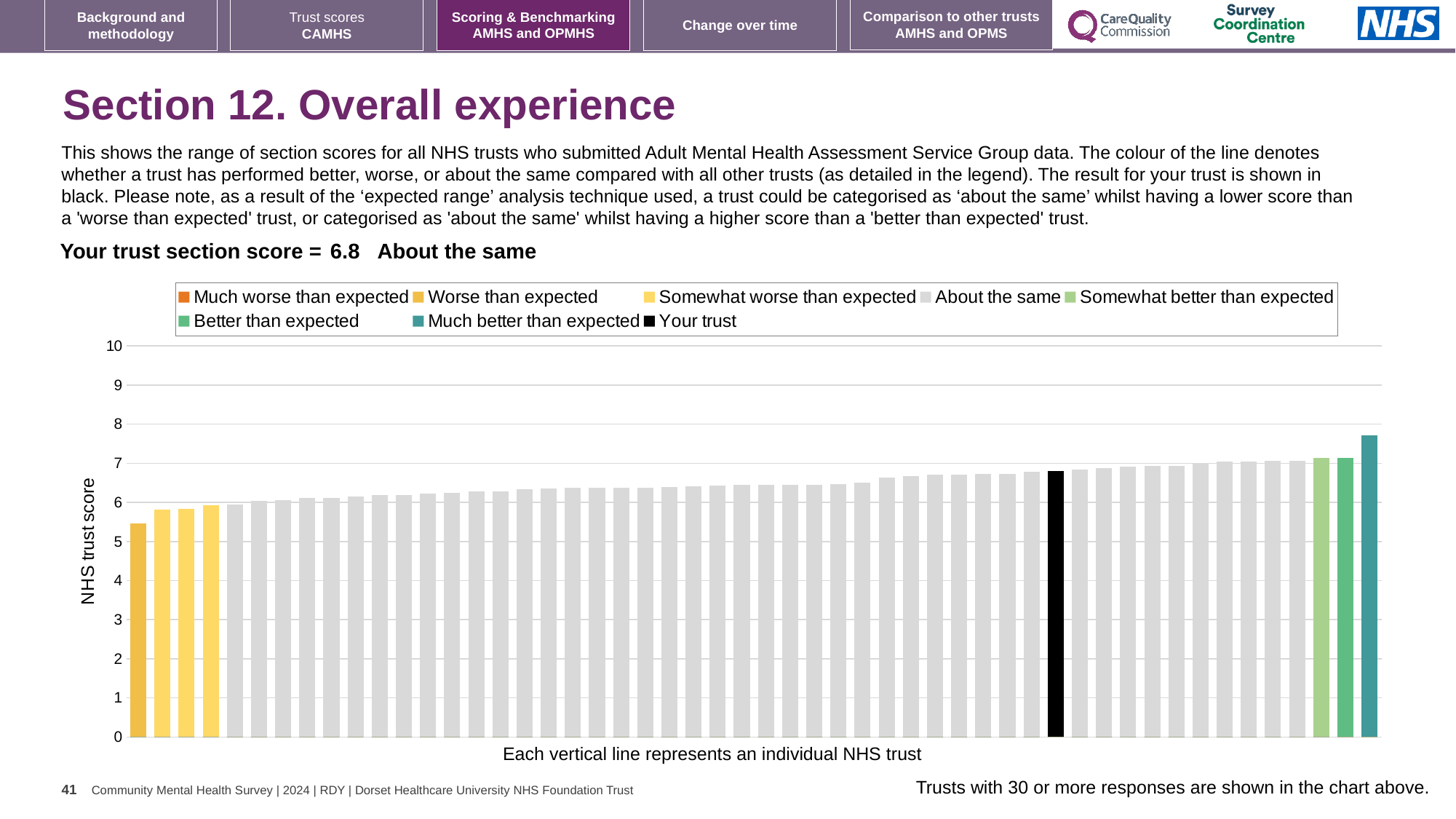
What kind of chart is shown on the slide? bar chart What is the label on the vertical axis of the chart? NHS trust score Is the value of the rightmost teal bar greater or less than 7? greater Is the value of the leftmost (lowest) bar greater or less than 5? greater Do the bar values rise or fall from left to right along the x axis? rise Is the value of the black 'Your trust' bar greater or less than 7? less Which legend category does the tallest bar belong to? Much better than expected How many teal 'Much better than expected' bars are in the chart? 1 Which is larger, the black 'Your trust' bar or the leftmost yellow bar? the black 'Your trust' bar How many entries does the chart legend list? 8 What is the section score for your trust shown on the slide? 6.8